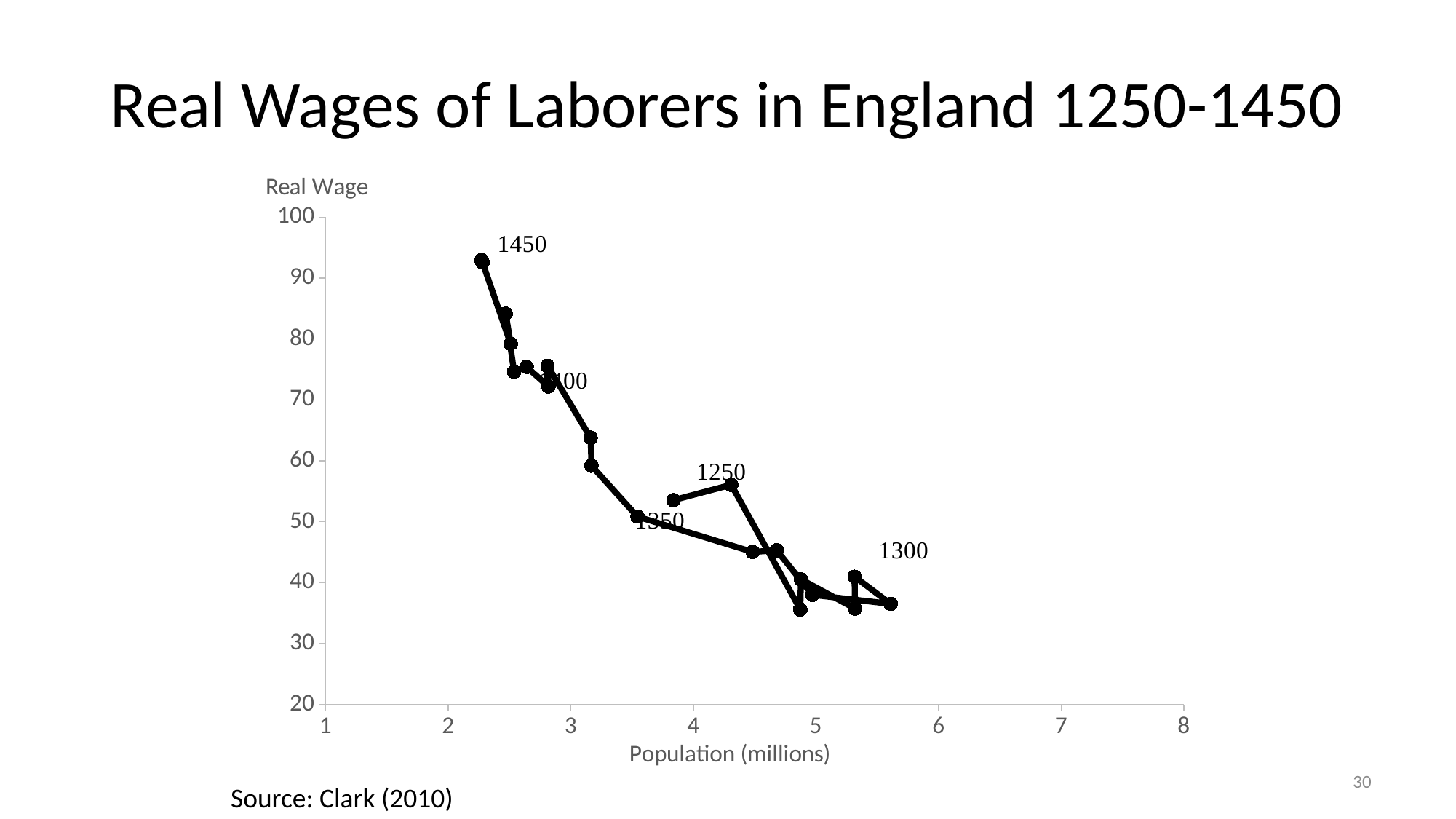
Among the labeled years, which has the lowest real wage? 1300 Is the population for the point labeled 1450 greater or less than 3 million? less Is the real wage for the point labeled 1300 greater or less than 50? less What is the label of the horizontal axis? Population (millions) What kind of chart is shown on the slide? Scatter (line) chart Is the real wage for the point labeled 1400 greater or less than 70? greater Which labeled year has the higher real wage, 1400 or 1350? 1400 Among the labeled years, which has the highest real wage? 1450 What is the title of the chart? Real Wages of Laborers in England 1250-1450